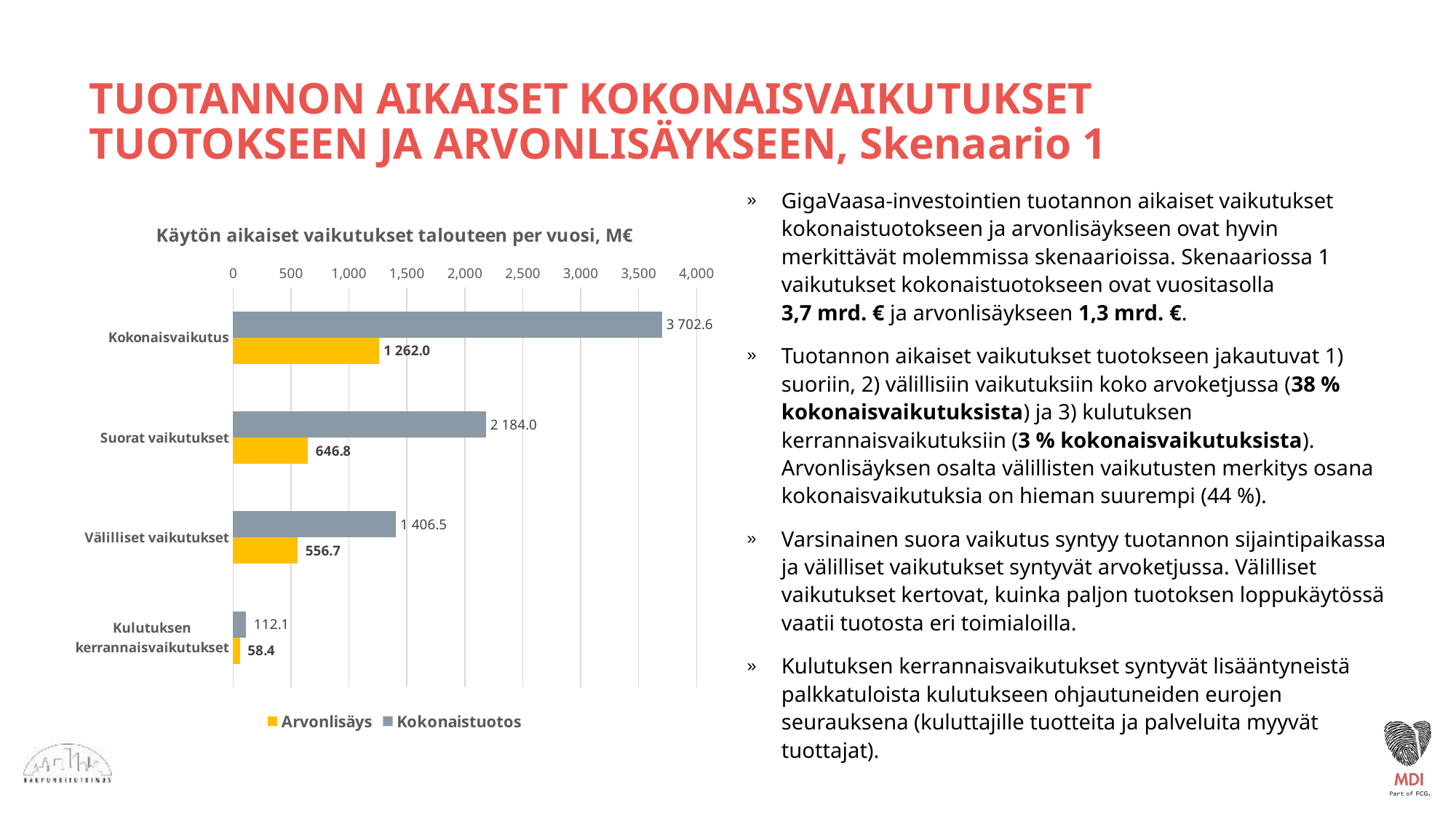
What is the Kokonaistuotos value for Kokonaisvaikutus? 3 702.6 Which category has the highest Arvonlisäys value? Kokonaisvaikutus What is the Arvonlisäys value for Kulutuksen kerrannaisvaikutukset? 58.4 What is the Kokonaistuotos value for Välilliset vaikutukset? 1 406.5 What type of chart is shown on the slide? Bar chart Which category has the lowest Kokonaistuotos value? Kulutuksen kerrannaisvaikutukset What is the difference between the Kokonaistuotos and Arvonlisäys values for Kulutuksen kerrannaisvaikutukset? 53.7 What is the difference between the Kokonaistuotos and Arvonlisäys values for Suorat vaikutukset? 1 537.2 What is the Arvonlisäys value for Suorat vaikutukset? 646.8 How many series does the legend list? 2 Which is larger: the Kokonaistuotos value for Suorat vaikutukset or the Kokonaistuotos value for Välilliset vaikutukset? Suorat vaikutukset How many categories are shown on the chart? 4